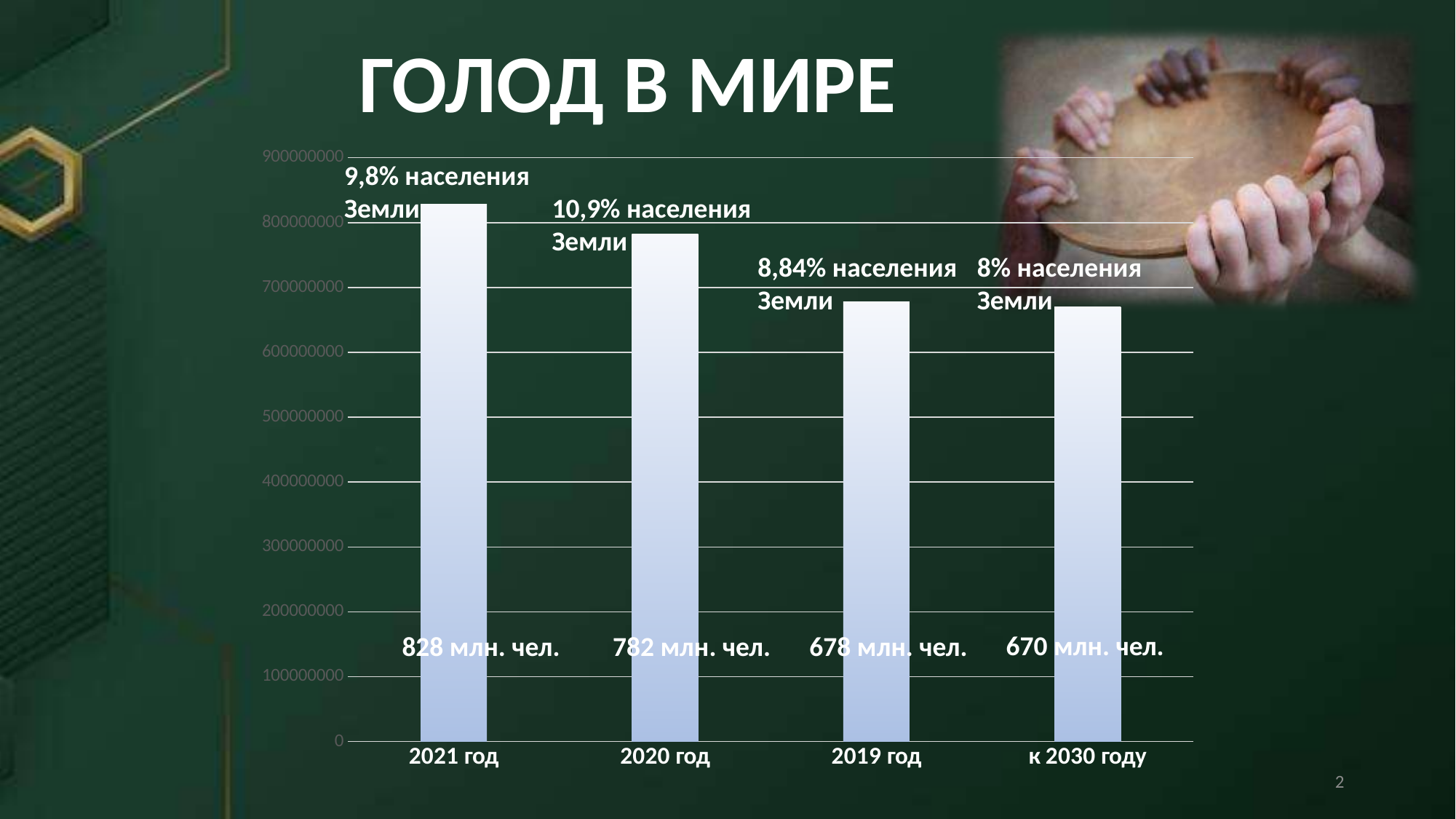
What share of the Earth's population is given for к 2030 году? 8% населения Земли What value is shown for 2019 год? 678 млн. чел. What value is shown for к 2030 году? 670 млн. чел. What type of chart is shown on the slide? Bar chart How many bars are in the chart? 4 Which category has the lowest value? к 2030 году What is the difference between the values for 2021 год and 2020 год? 46 млн. чел. What share of the Earth's population is given for 2020 год? 10,9% населения Земли Which is larger, the value for 2019 год or the value for 2020 год? 2020 год What value is shown for 2020 год? 782 млн. чел. What value is shown for 2021 год? 828 млн. чел. Which category has the highest value? 2021 год